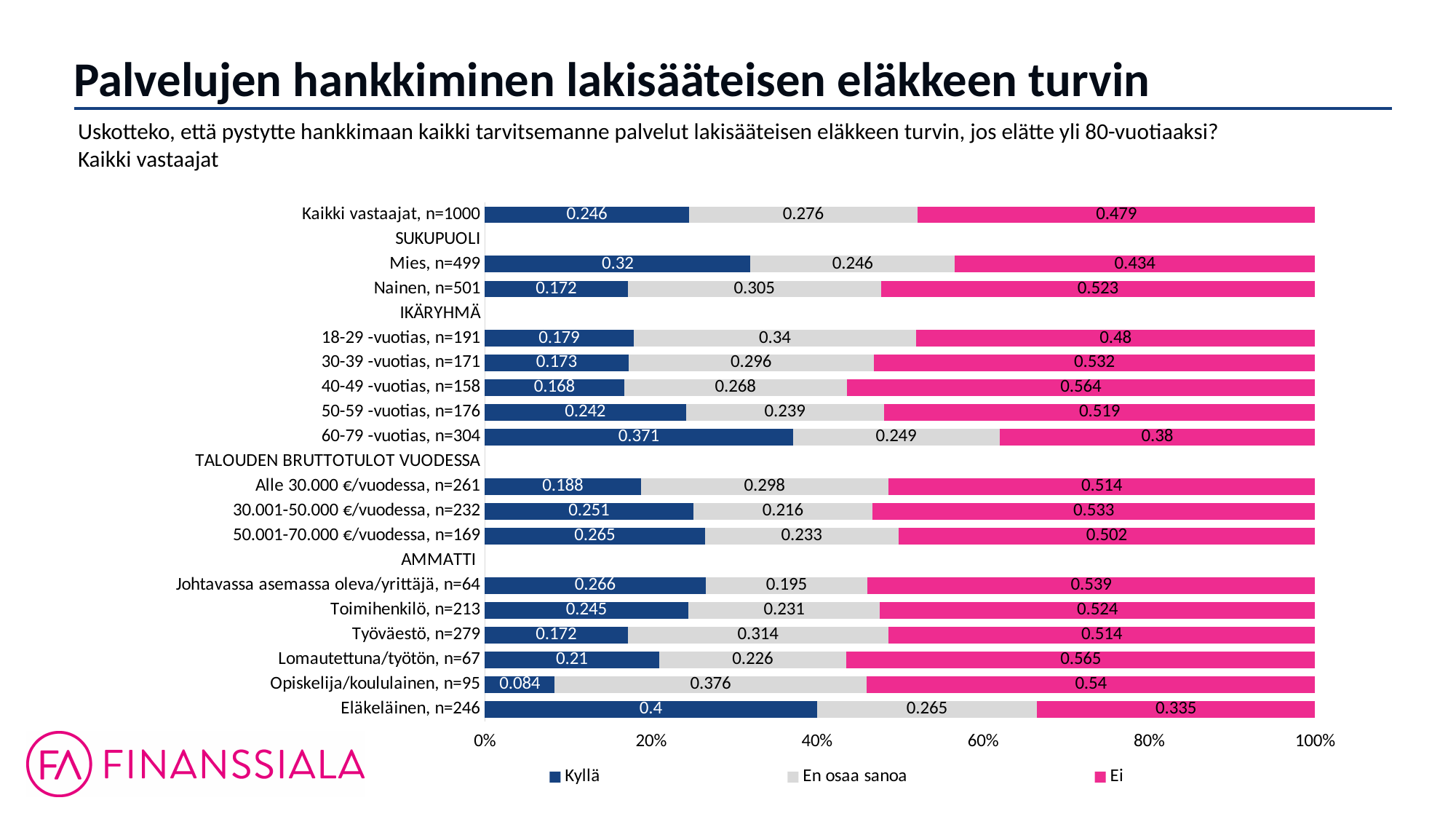
What is the difference between the Kyllä values for Mies, n=499 and Nainen, n=501? 0.148 What is the total of the three segments for Mies, n=499? 1.0 Which category has the highest Kyllä value? Eläkeläinen, n=246 How many categories have bars plotted in the chart? 17 What is the Kyllä value for Eläkeläinen, n=246? 0.4 Which category has the lowest Ei value? Eläkeläinen, n=246 How many series does the legend list? 3 Which has the larger Kyllä value: 60-79 -vuotias, n=304 or 18-29 -vuotias, n=191? 60-79 -vuotias, n=304 Which category has the lowest Kyllä value? Opiskelija/koululainen, n=95 What is the Ei value for Mies, n=499? 0.434 What kind of chart is shown on the slide? Stacked bar chart What is the En osaa sanoa value for Opiskelija/koululainen, n=95? 0.376